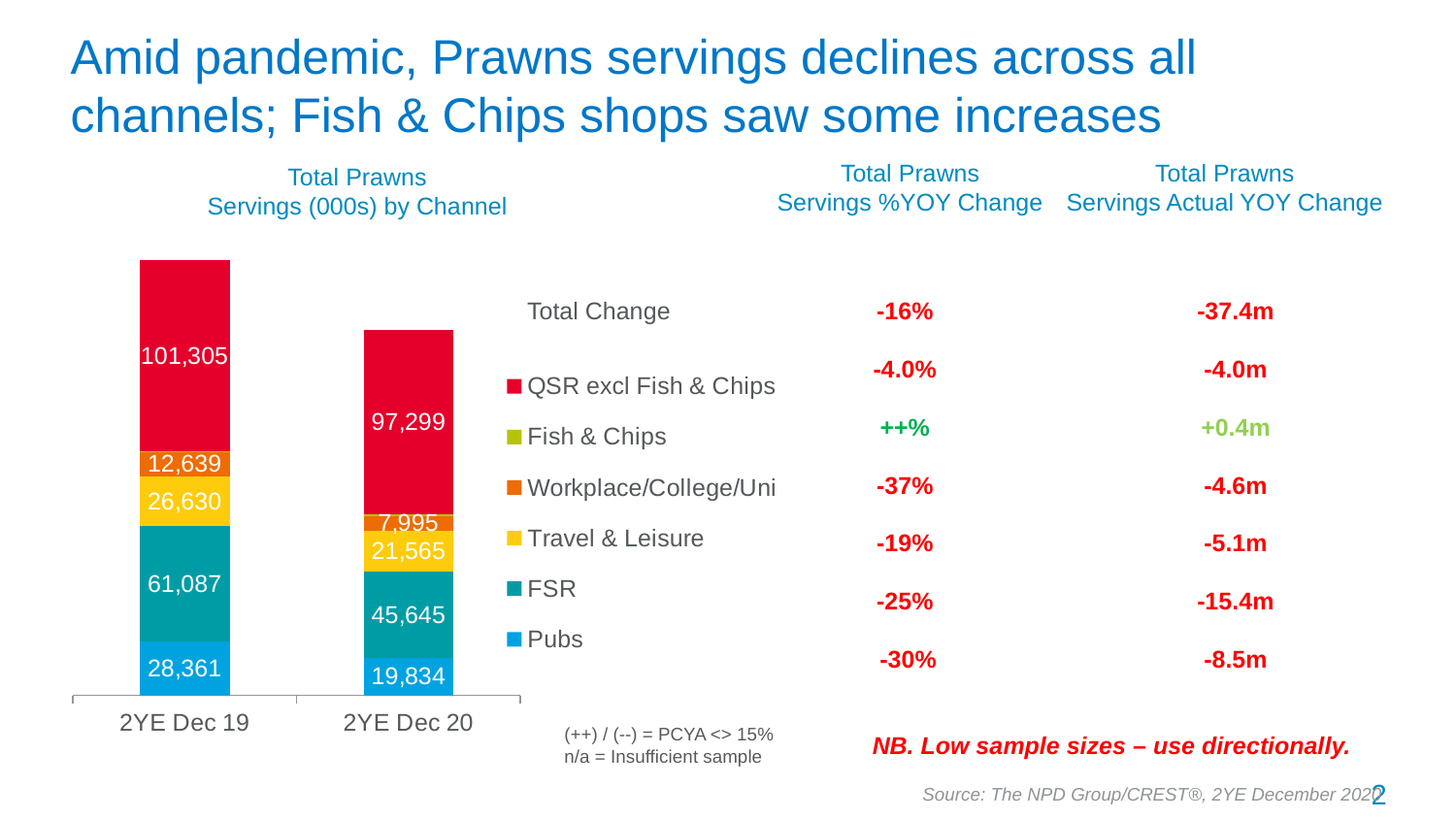
Which channel has the largest segment in the 2YE Dec 20 bar? QSR excl Fish & Chips What is the value for QSR excl Fish & Chips in 2YE Dec 19? 101,305 Which is larger, the QSR excl Fish & Chips value for 2YE Dec 19 or for 2YE Dec 20? 2YE Dec 19 What is the value for FSR in 2YE Dec 19? 61,087 What is the difference between the Pubs values for 2YE Dec 19 and 2YE Dec 20? 8,527 What is the value for Travel & Leisure in 2YE Dec 20? 21,565 What is the difference between the FSR values for 2YE Dec 19 and 2YE Dec 20? 15,442 What is the value for Pubs in 2YE Dec 20? 19,834 What kind of chart is shown on the slide? Stacked bar chart What is the value for Workplace/College/Uni in 2YE Dec 19? 12,639 How many bars are shown on the x axis of the chart? 2 How many series does the chart legend list? 6